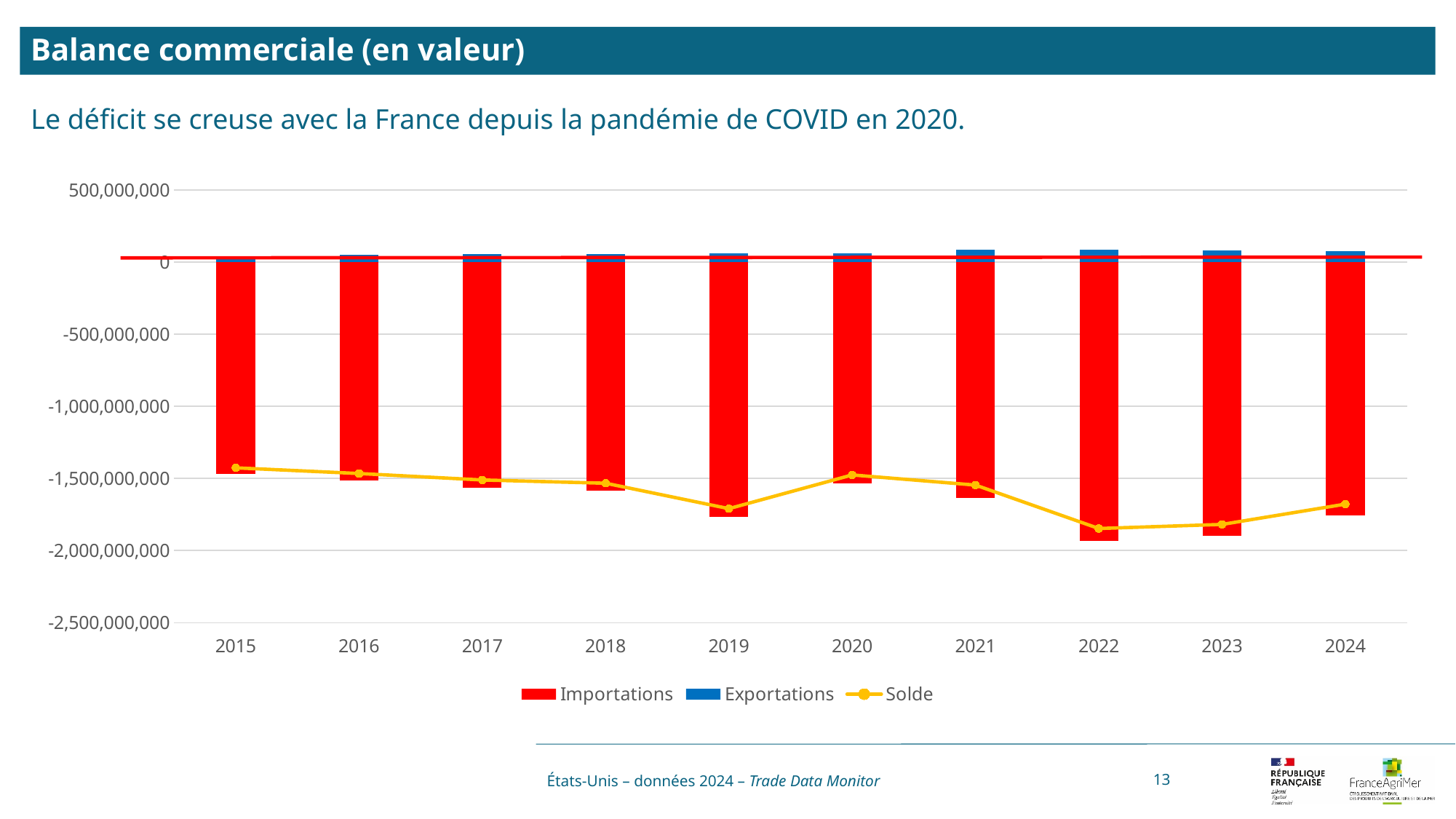
Does the Solde line rise or fall from 2022 to 2024? Rise How many years are shown on the x axis of the chart? 10 Does the Solde line rise or fall from 2020 to 2022? Fall What colour are the Importations bars? Red Is the Solde value for 2024 greater or less than -2,000,000,000? greater How many series does the chart legend list? 3 Which year has the higher Solde value, 2019 or 2020? 2020 Is the Solde value for 2019 greater or less than -1,500,000,000? less Is the Importations value for 2022 greater or less than -1,500,000,000? less Which series are listed in the chart legend? Importations, Exportations, Solde What kind of chart is shown on the slide? A combined bar and line chart